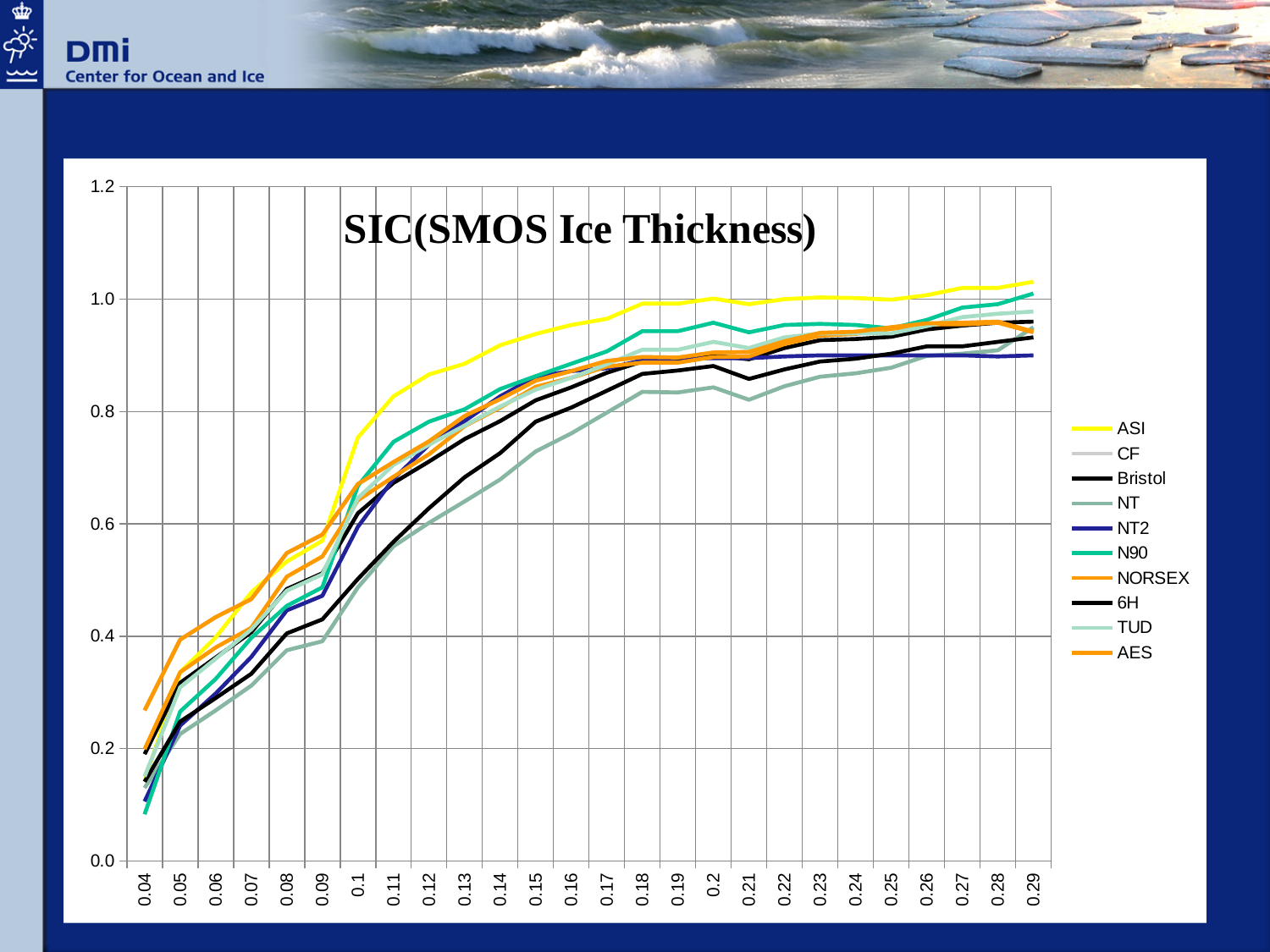
Is the value for ASI at x = 0.1 greater or less than 0.6? greater Which series has the lowest value at x = 0.2? NT Do the values generally rise or fall along the x axis? rise What is the title of the chart? SIC(SMOS Ice Thickness) Which series has the highest value at x = 0.1? ASI Which series has the highest value at x = 0.29? ASI How many points are there along the x axis? 26 Is the value for ASI at x = 0.29 greater or less than 1.0? greater Which colour is used for the ASI series in the legend? yellow How many series does the legend list? 10 What kind of chart is shown on the slide? line chart Is the value for NT at x = 0.04 greater or less than 0.2? less